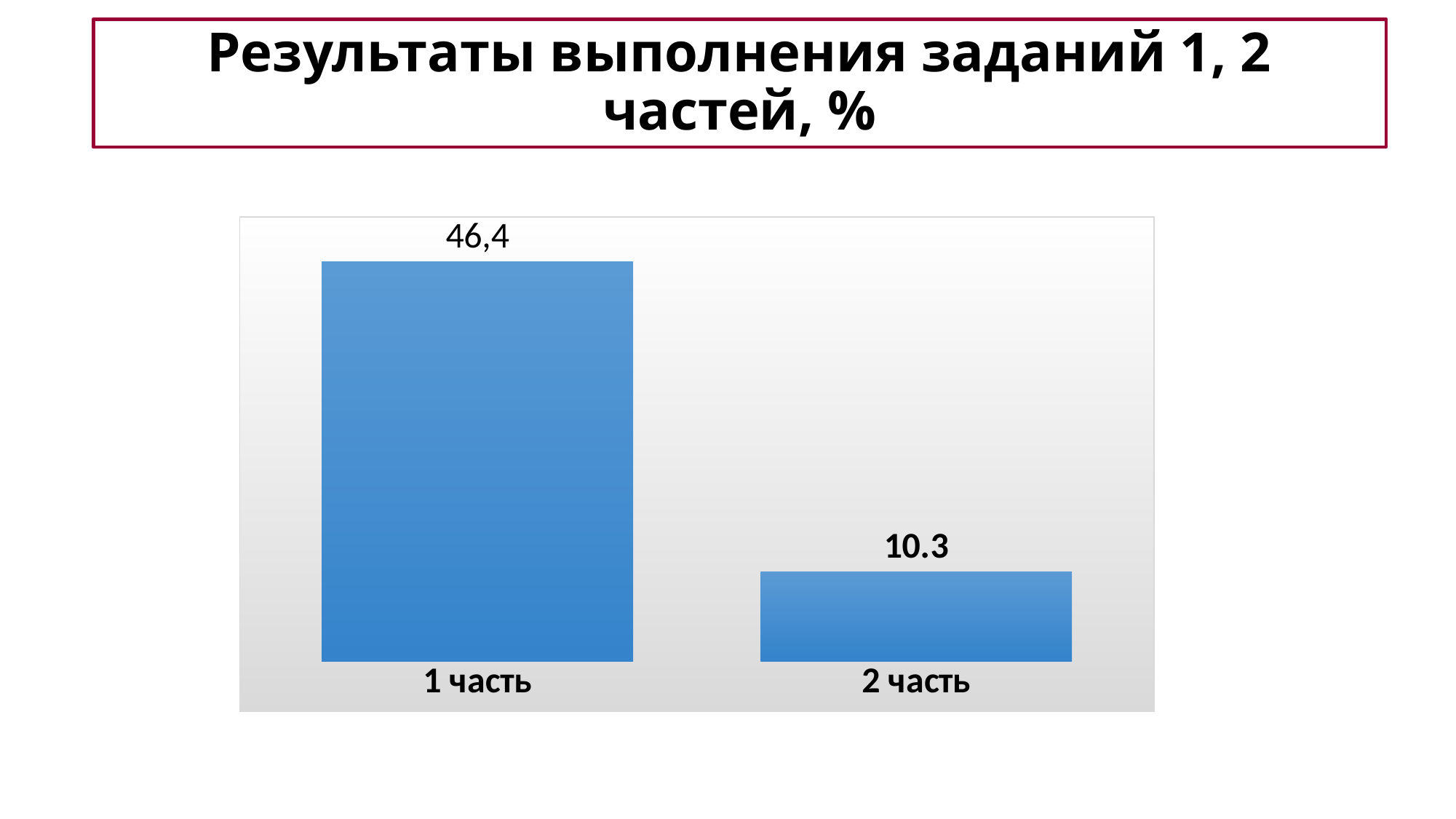
What colour are the bars in the chart? blue What is the difference between the value for 1 часть and the value for 2 часть? 36.1 Which is larger, the value for 1 часть or the value for 2 часть? 1 часть What is the title of the slide? Результаты выполнения заданий 1, 2 частей, % Do the values rise or fall from 1 часть to 2 часть? fall What is the value for 1 часть? 46,4 Which category has the lowest value? 2 часть What is the value for 2 часть? 10.3 How many categories are shown in the chart? 2 What kind of chart is shown on the slide? bar chart Which category has the highest value? 1 часть